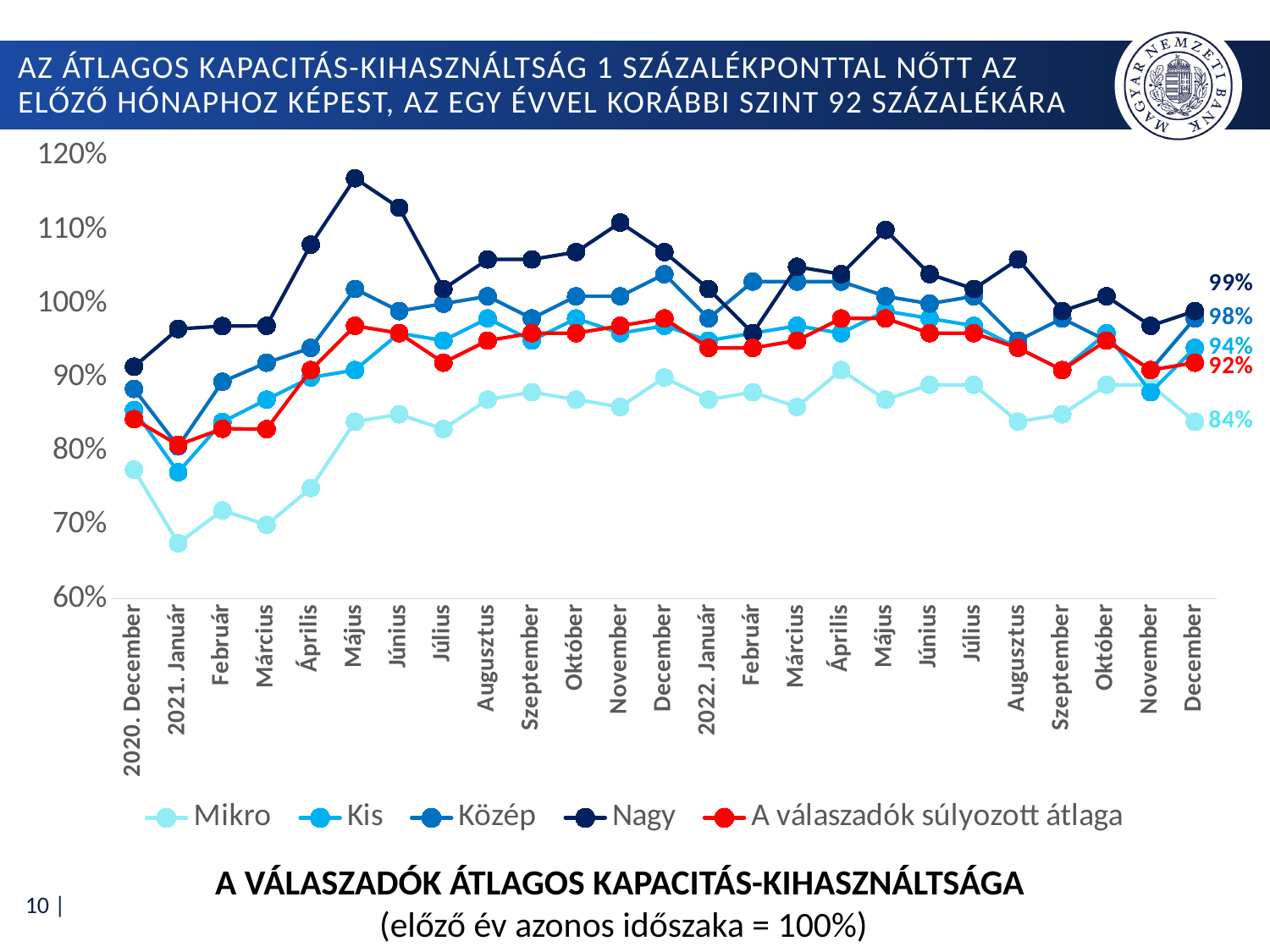
Which series has the highest value in December 2022? Nagy Is the value for Mikro in 2021. Január greater or less than 70%? less Which series has the lowest value in December 2022? Mikro What is the value for the Nagy series in December 2022? 99% What is the difference between the Nagy and Mikro values in December 2022? 15 percentage points What is the value for the Mikro series in December 2022? 84% Is the value for Nagy in Május 2021 greater or less than 110%? greater What is the value of 'A válaszadók súlyozott átlaga' in December 2022? 92% How many series does the legend list? 5 How many months (data points) are shown along the x axis? 25 What is the value for the Kis series in December 2022? 94% What kind of chart is shown on the slide? line chart